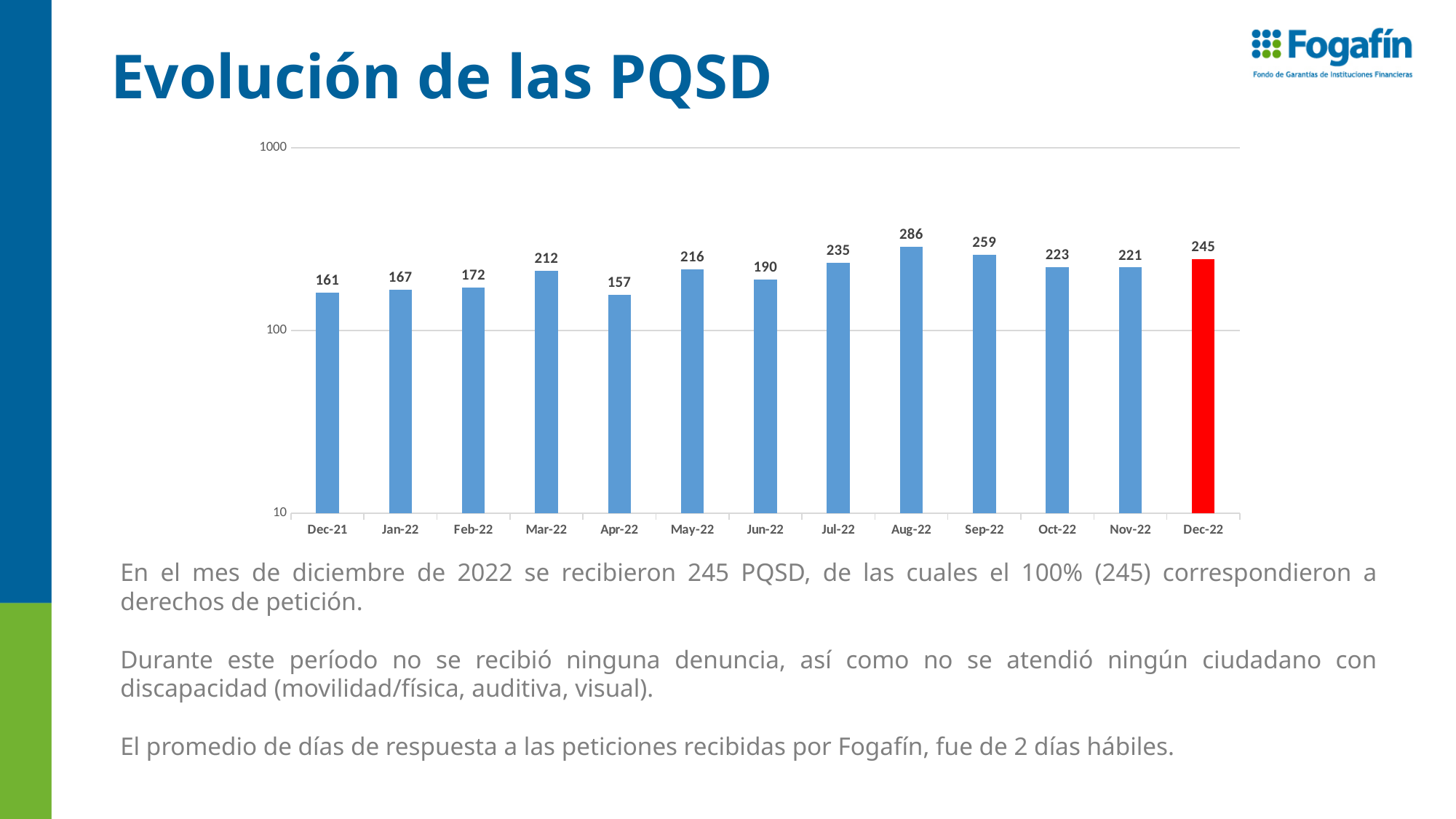
What is the title of the slide containing the chart? Evolución de las PQSD What kind of chart is shown on the slide? bar chart Is the value for Jun-22 greater or less than 100? greater Which month has the highest value? Aug-22 How many months are shown on the x axis? 13 Which month has the lowest value? Apr-22 Which bar is coloured red instead of blue? Dec-22 What is the value for Dec-22? 245 Which is larger, the value for Sep-22 or the value for Oct-22? Sep-22 What is the difference between the values for Dec-22 and Dec-21? 84 What is the value for Aug-22? 286 What is the value for Apr-22? 157